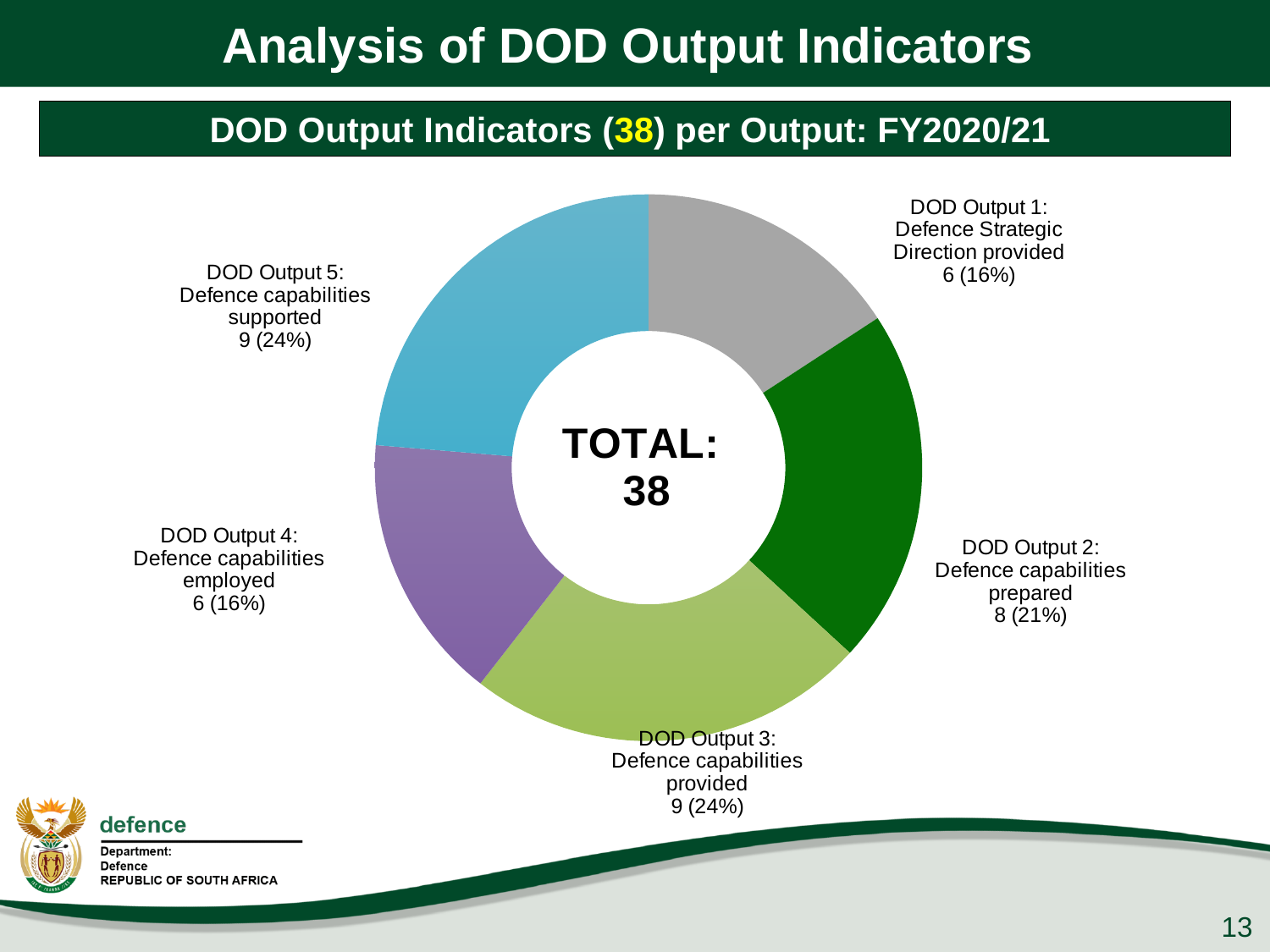
How many DOD Output indicators are there for DOD Output 2: Defence capabilities prepared? 8 How many indicators does DOD Output 5: Defence capabilities supported have? 9 How many categories (DOD Outputs) are shown in the chart? 5 What percentage share does DOD Output 1: Defence Strategic Direction provided have? 16% Which has more indicators, DOD Output 2: Defence capabilities prepared or DOD Output 4: Defence capabilities employed? DOD Output 2: Defence capabilities prepared What kind of chart is shown on the slide? Doughnut (pie) chart What percentage share does DOD Output 3: Defence capabilities provided have? 24% What is the title shown above the chart? DOD Output Indicators (38) per Output: FY2020/21 What is the difference in indicators between DOD Output 5 and DOD Output 1? 3 What is the total number of DOD Output indicators shown in the centre of the chart? 38 What is the difference in the number of indicators between DOD Output 3 and DOD Output 2? 1 Which DOD Output has the fewest indicators? DOD Output 1 and DOD Output 4 (6 each)